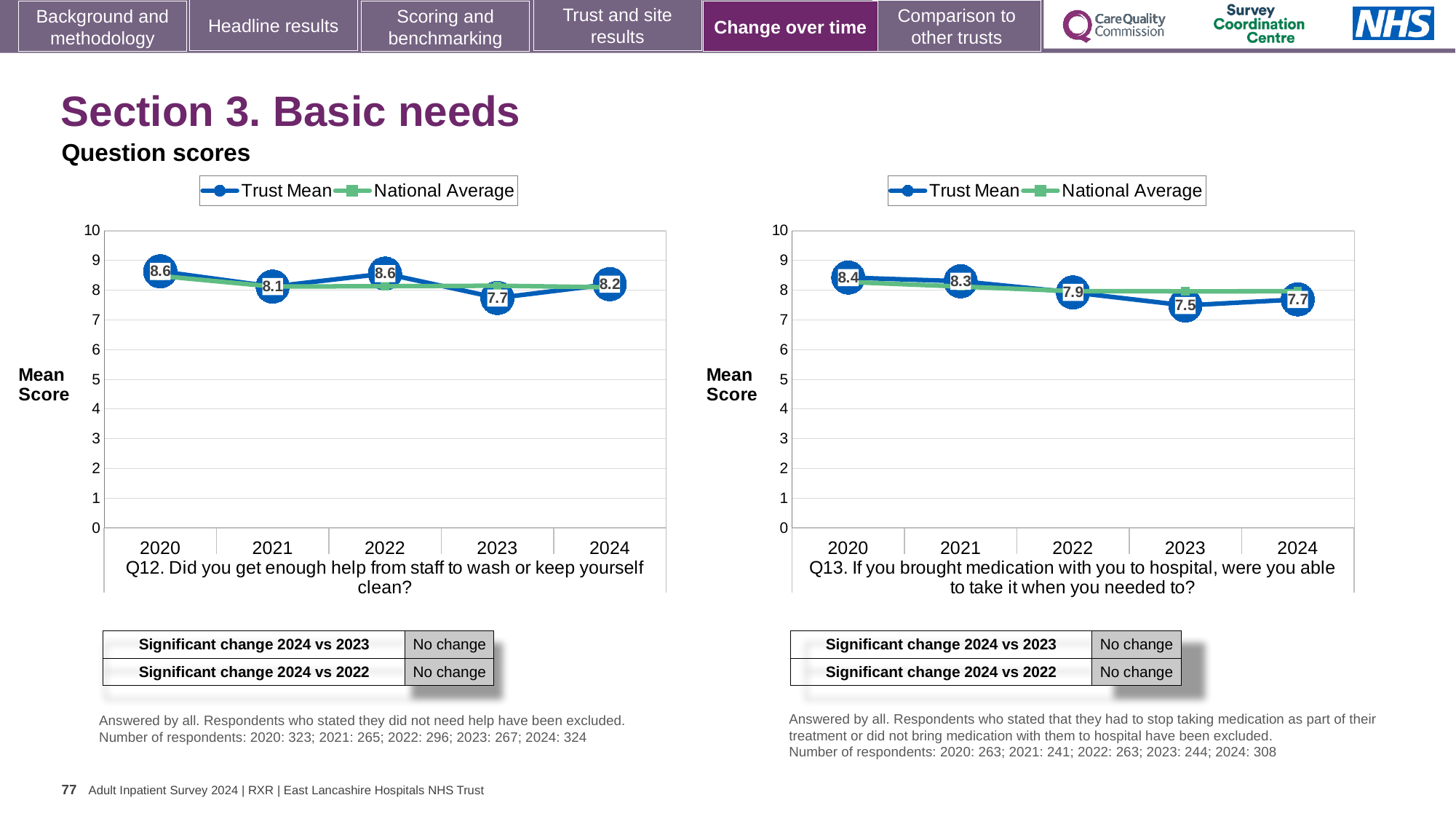
In the Q12 chart (left), is the Trust Mean higher in 2021 or 2024? 2024 In the Q13 chart (right), what is the difference between the Trust Mean for 2020 and 2024? 0.7 In the Q13 chart (right), what is the Trust Mean for 2022? 7.9 In the Q12 chart (left), what is the Trust Mean for 2023? 7.7 In the Q13 chart (right), which year has the highest Trust Mean? 2020 In the Q12 chart (left), what is the Trust Mean for 2020? 8.6 What type of chart is used for Q12 (left)? Line chart In the Q13 chart (right), which year has the lowest Trust Mean? 2023 How many series does the legend of the Q13 chart (right) list? 2 In the Q12 chart (left), what is the difference between the Trust Mean for 2022 and 2023? 0.9 In the Q13 chart (right), what is the Trust Mean for 2024? 7.7 How many years are plotted on the x axis of the Q12 chart (left)? 5